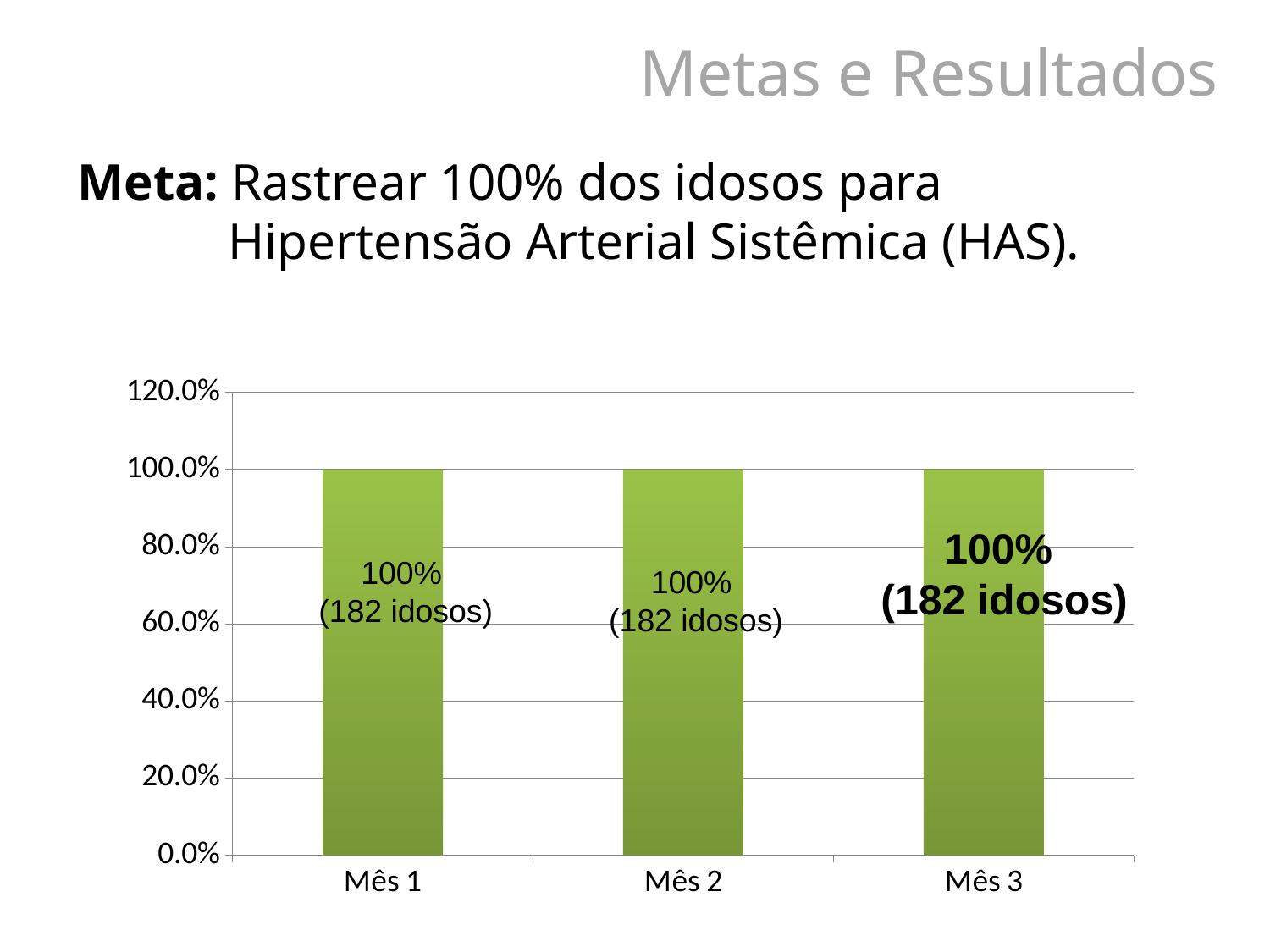
What is the value for Mês 3? 100% How many categories are shown on the x axis? 3 What is the highest value shown on the y axis? 120.0% Do the values rise, fall or stay the same from Mês 1 to Mês 3? stay the same What kind of chart is this? bar chart Is the value for Mês 1 greater or less than 120.0%? less How many idosos does the data label for Mês 3 report? 182 idosos How many idosos does the data label for Mês 1 report? 182 idosos What is the value for Mês 2? 100% What is the difference between the values for Mês 3 and Mês 1? 0% Is the value for Mês 2 greater or less than 80.0%? greater What is the value for Mês 1? 100%